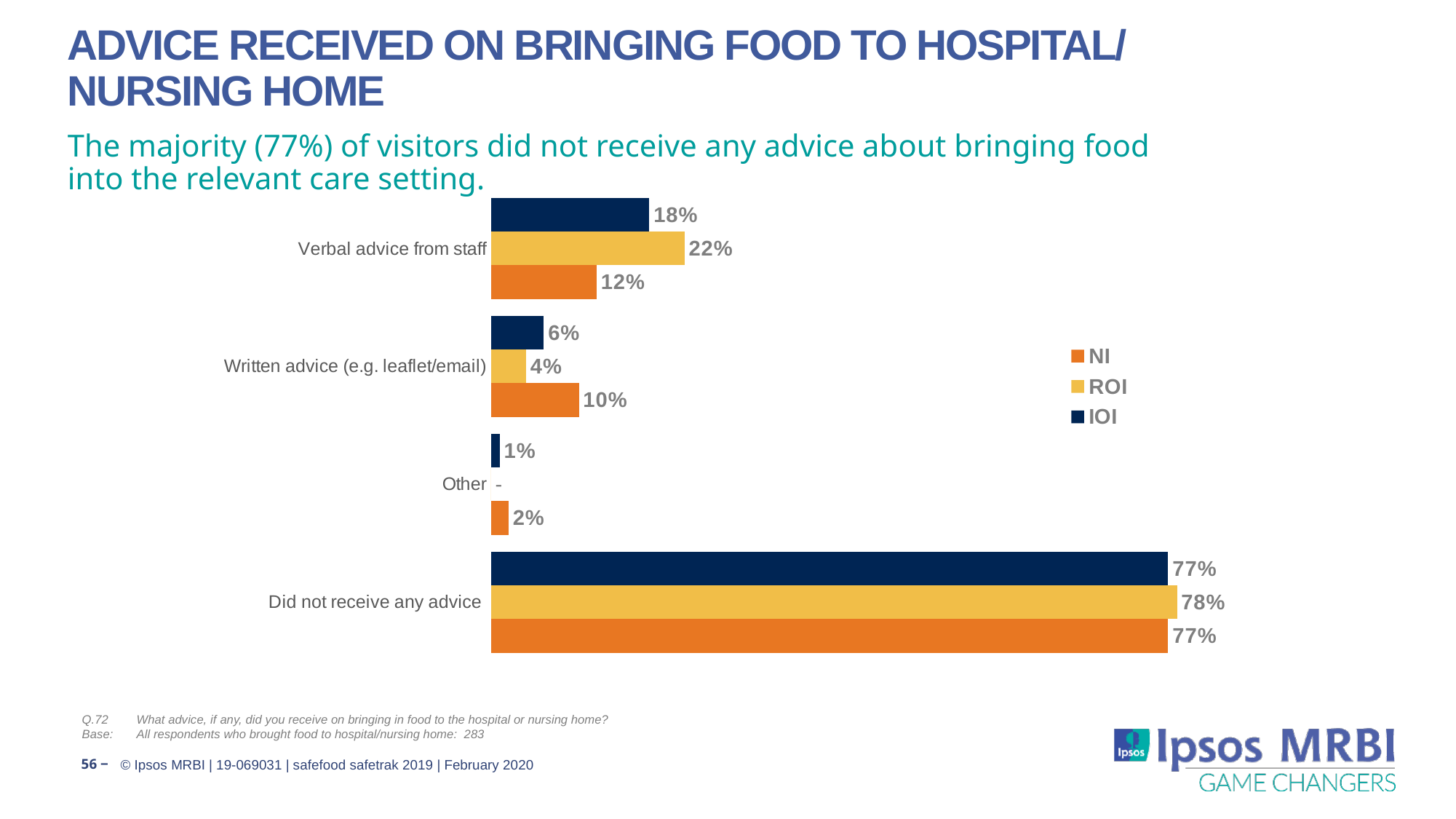
How many series does the legend list? 3 What kind of chart is shown on the slide? Bar chart Which category has the highest ROI value? Did not receive any advice What is the difference between the ROI and NI values for Verbal advice from staff? 10% What is the NI value for Other? 2% What is the IOI value for Did not receive any advice? 77% Which colour represents the IOI series in the legend? Dark navy blue What is the ROI value for Verbal advice from staff? 22% For Written advice (e.g. leaflet/email), which is larger: the NI value or the ROI value? NI Which category has the lowest NI value? Other What is the NI value for Written advice (e.g. leaflet/email)? 10% How many categories are shown on the chart? 4